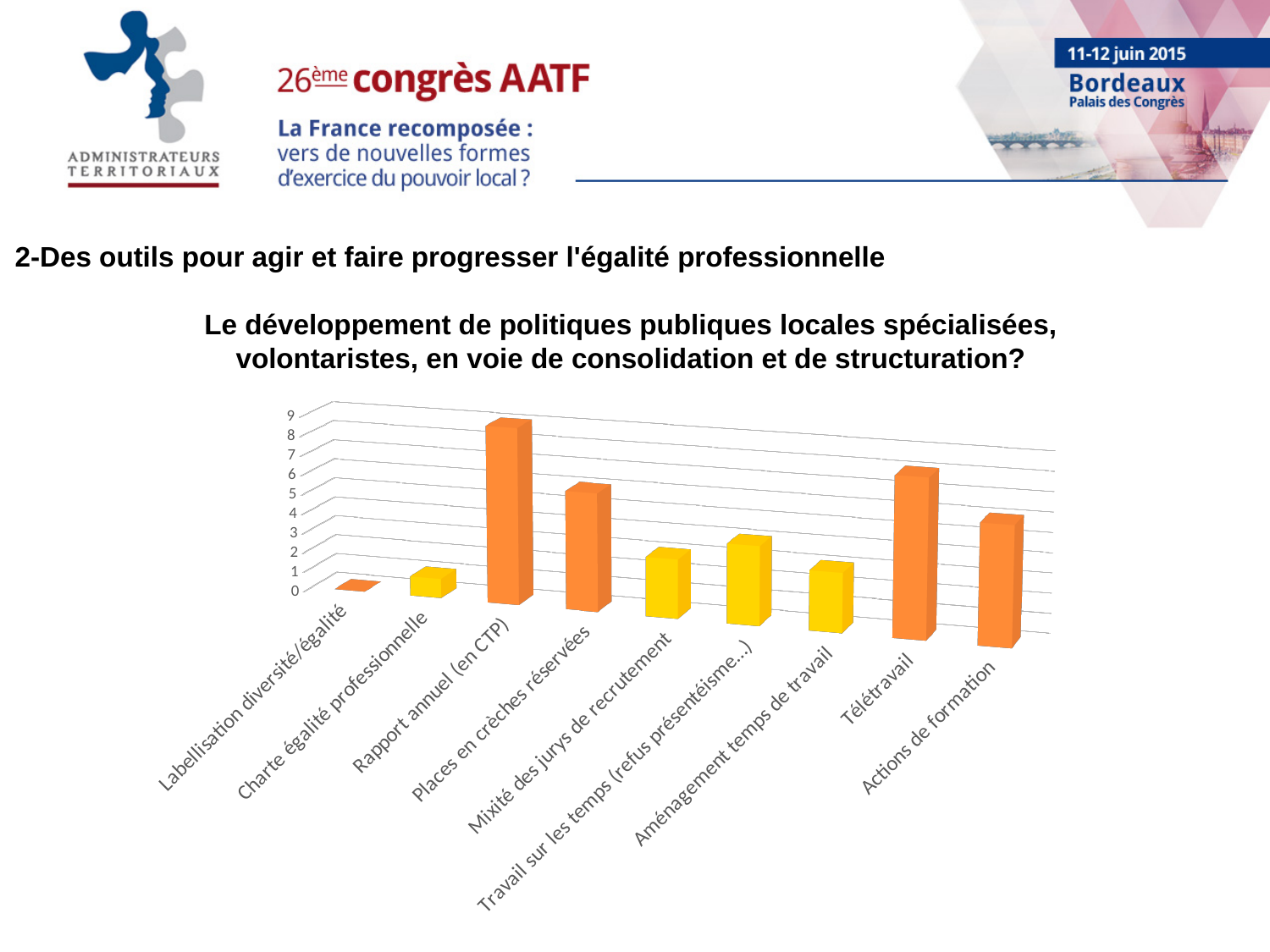
What is the highest value shown on the vertical axis of the chart? 9 Is the value for Rapport annuel (en CTP) greater or less than 7? greater Which is larger, the bar for Rapport annuel (en CTP) or the bar for Télétravail? Rapport annuel (en CTP) What kind of chart is shown on the slide? bar chart Is the value for Aménagement temps de travail greater or less than 4? less Which category has the lowest bar in the chart? Labellisation diversité/égalité Is the value for Charte égalité professionnelle greater or less than 3? less Which category has the highest bar in the chart? Rapport annuel (en CTP) How many categories are shown on the x axis of the chart? 9 Which is larger, the bar for Télétravail or the bar for Actions de formation? Télétravail